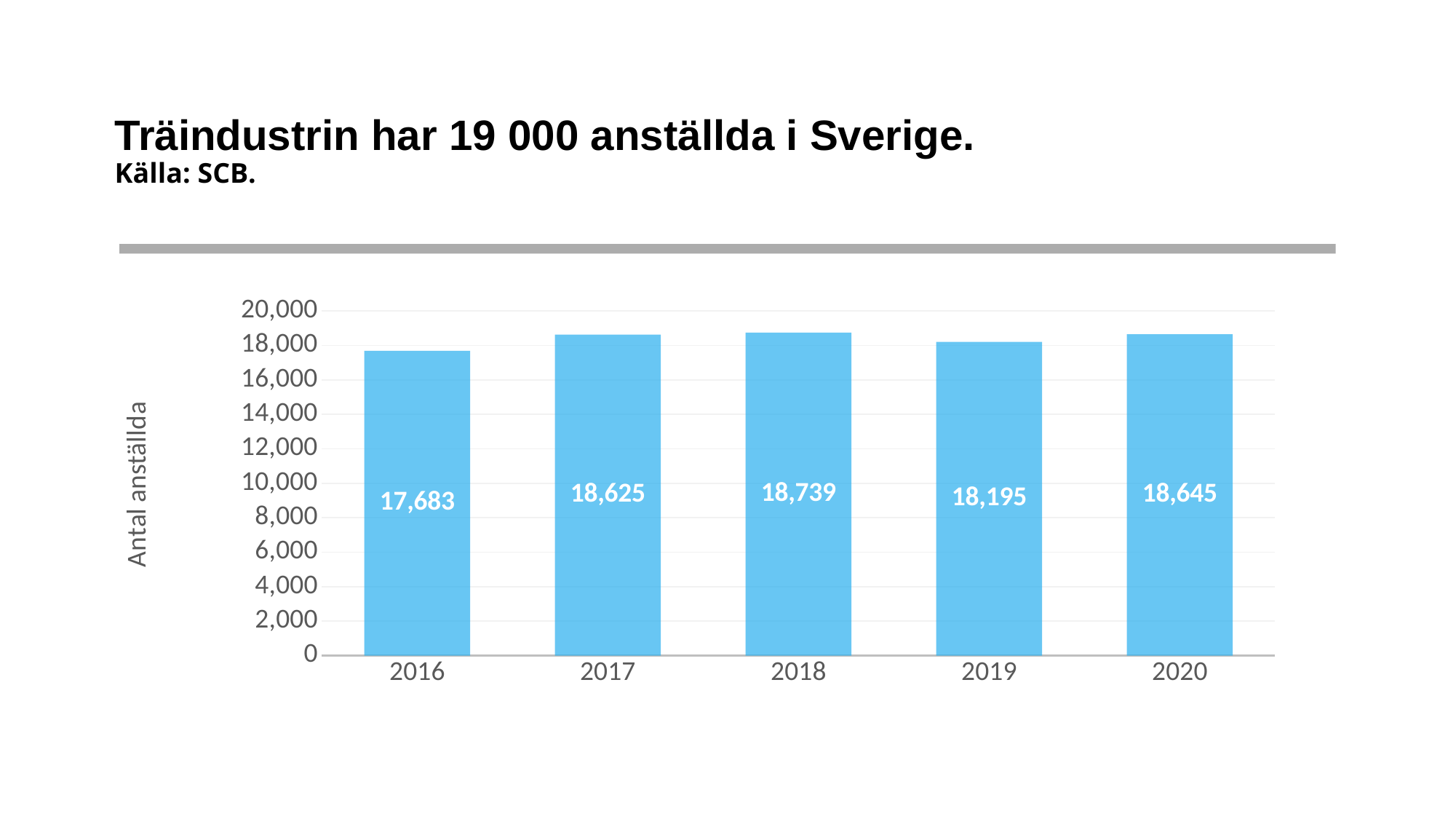
Which year has the lowest number of employees? 2016 What is the difference between the values for 2017 and 2019? 430 What is the value shown for 2020? 18,645 What is the difference between the values for 2018 and 2016? 1,056 What is the value shown for 2019? 18,195 Which year has a larger value, 2017 or 2019? 2017 What is the value shown for 2018? 18,739 How many years are shown on the x axis? 5 What kind of chart is shown on the slide? Bar chart Which year has the highest number of employees? 2018 What is the label on the vertical axis? Antal anställda What is the number of employees (Antal anställda) shown for 2016? 17,683